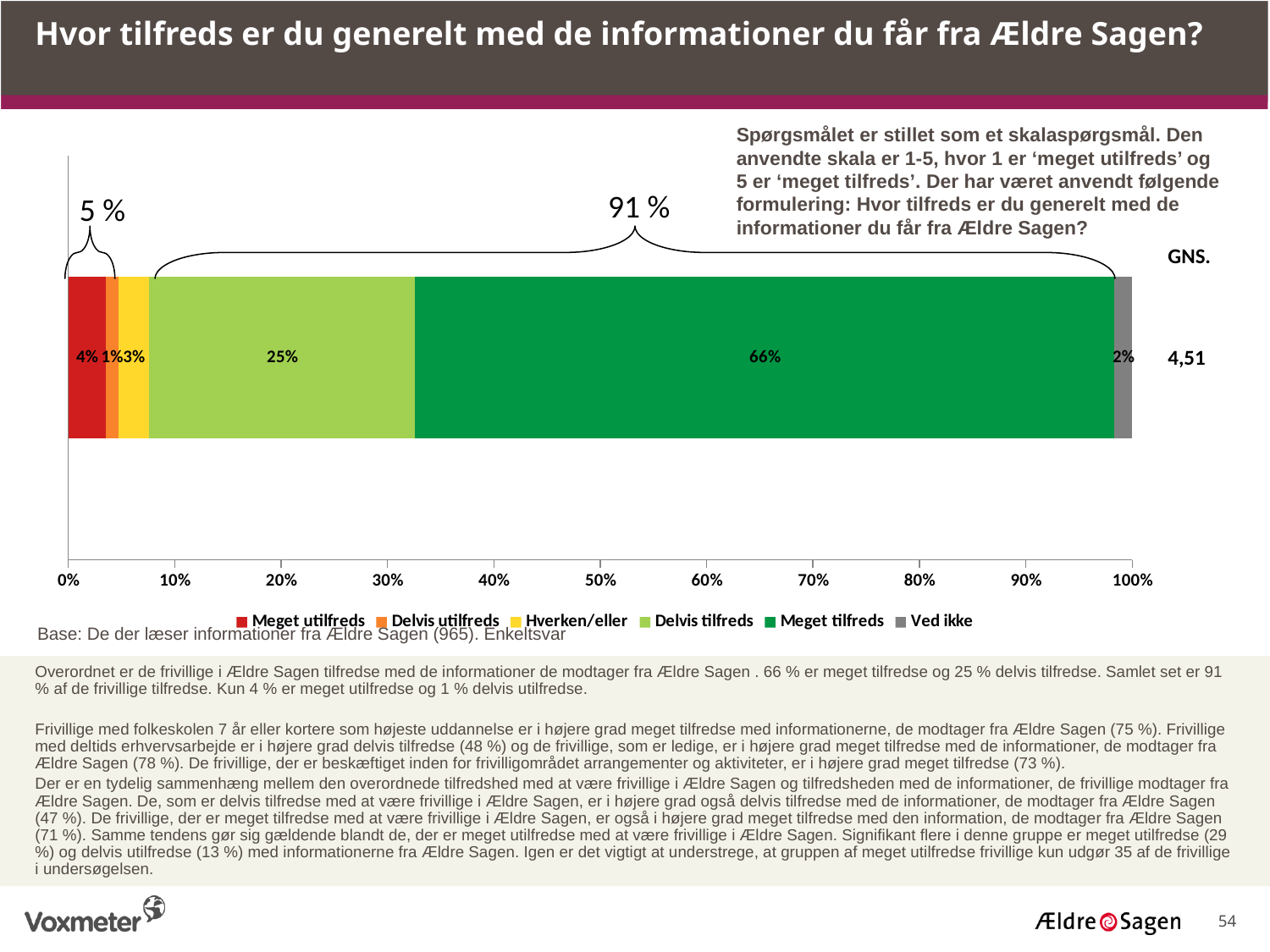
What is the average score (GNS.) shown to the right of the bar? 4,51 What percentage of respondents answered 'Meget utilfreds'? 4% Which is larger, the share for 'Hverken/eller' or the share for 'Meget utilfreds'? Meget utilfreds What kind of chart is shown on the slide? Stacked bar chart How many series does the legend list? 6 What combined percentage is shown by the bracket above the 'Delvis tilfreds' and 'Meget tilfreds' segments? 91 % What percentage of respondents answered 'Delvis tilfreds'? 25% What percentage of respondents answered 'Ved ikke'? 2% What percentage of respondents answered 'Meget tilfreds'? 66% What is the difference in percentage points between 'Meget tilfreds' and 'Delvis tilfreds'? 41 Which response category has the largest share of the bar? Meget tilfreds Which response category has the smallest share of the bar? Delvis utilfreds